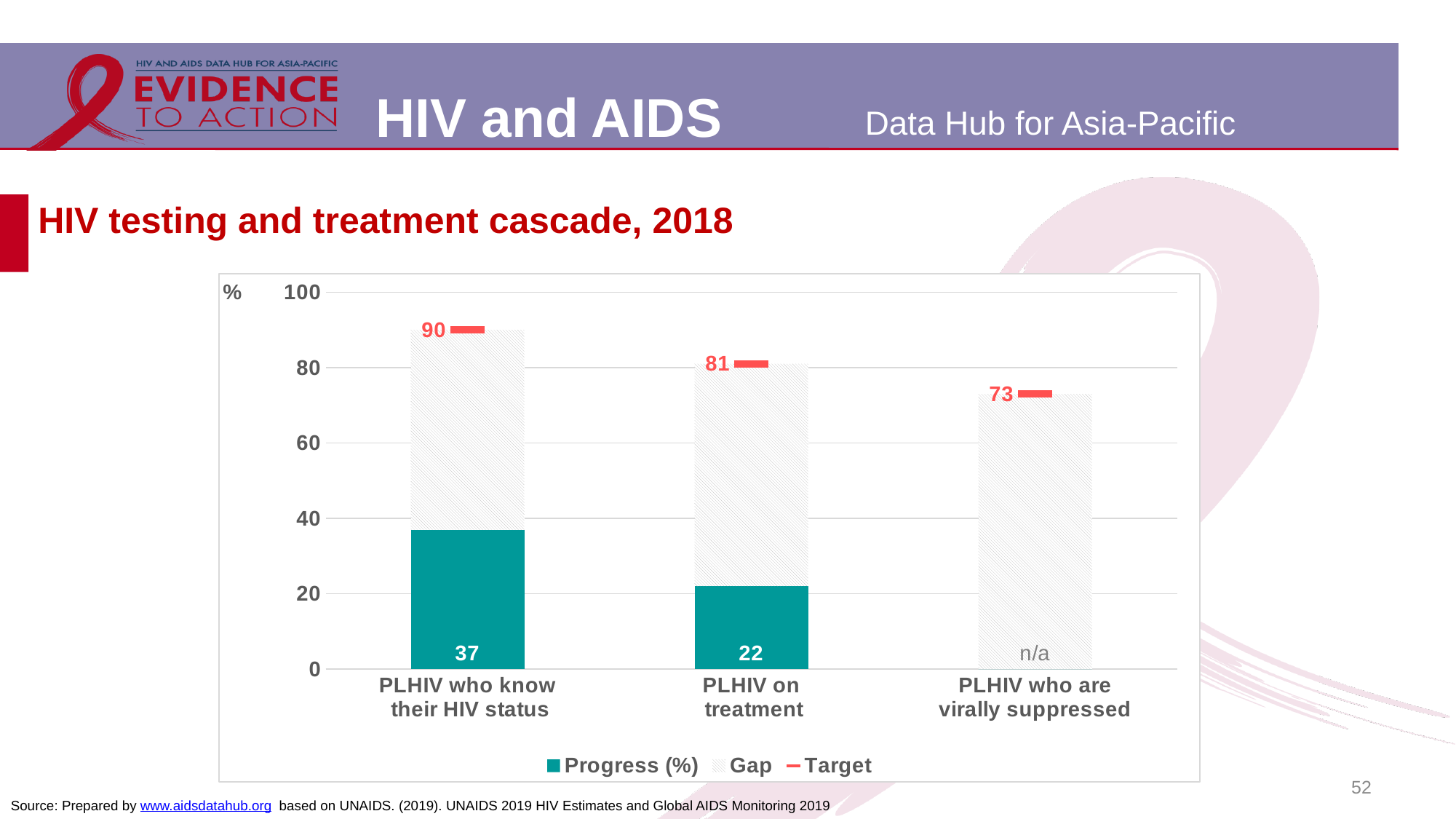
What is the difference between the Target and the Progress (%) value for PLHIV who know their HIV status? 53 What is the Progress (%) value for PLHIV who know their HIV status? 37 What is the Target value for PLHIV who are virally suppressed? 73 What is the Progress (%) value for PLHIV on treatment? 22 Which category has the highest Target value? PLHIV who know their HIV status Which category has the lowest Target value? PLHIV who are virally suppressed What is shown as the Progress (%) value for PLHIV who are virally suppressed? n/a What is the title of the chart? HIV testing and treatment cascade, 2018 Which is larger, the Progress (%) value for PLHIV who know their HIV status or for PLHIV on treatment? PLHIV who know their HIV status What is the Target value for PLHIV on treatment? 81 How many series does the legend list? 3 What is the Target value for PLHIV who know their HIV status? 90